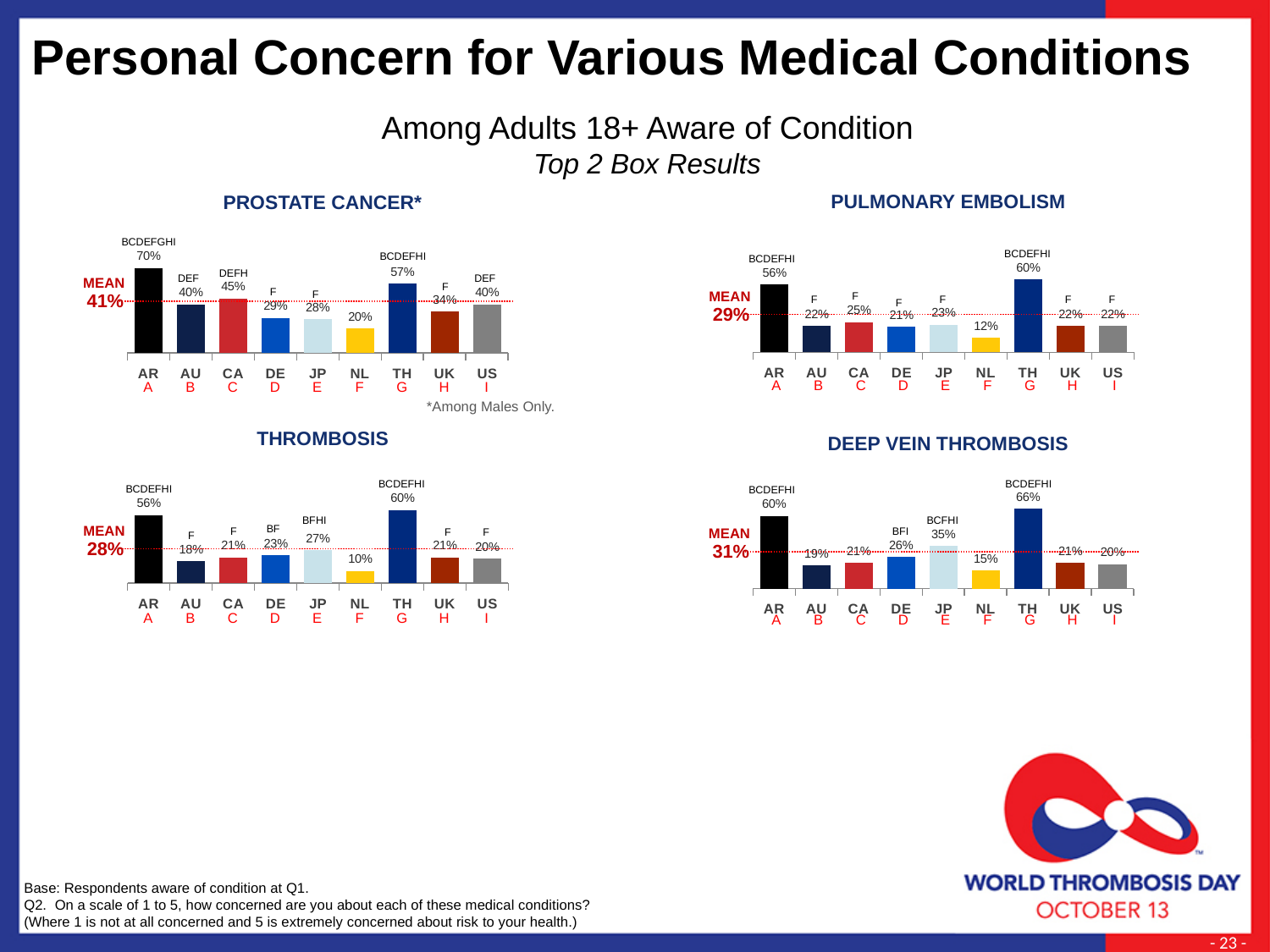
In the Pulmonary Embolism chart, which country has the highest value? TH In the Pulmonary Embolism chart, what is the value for CA? 25% In the Prostate Cancer chart, what is the mean shown? 41% In the Prostate Cancer chart, which country has the lowest value? NL In the Thrombosis chart, what is the value for NL? 10% In the Deep Vein Thrombosis chart, what is the difference between JP and DE? 9% In the Thrombosis chart, what is the value for JP? 27% In the Deep Vein Thrombosis chart, what is the value for TH? 66% In the Prostate Cancer chart, what is the value for AR? 70% How many countries are shown in the Deep Vein Thrombosis chart? 9 In the Thrombosis chart, which is larger, the value for AR or the value for TH? TH In the Pulmonary Embolism chart, what is the difference between TH and NL? 48%